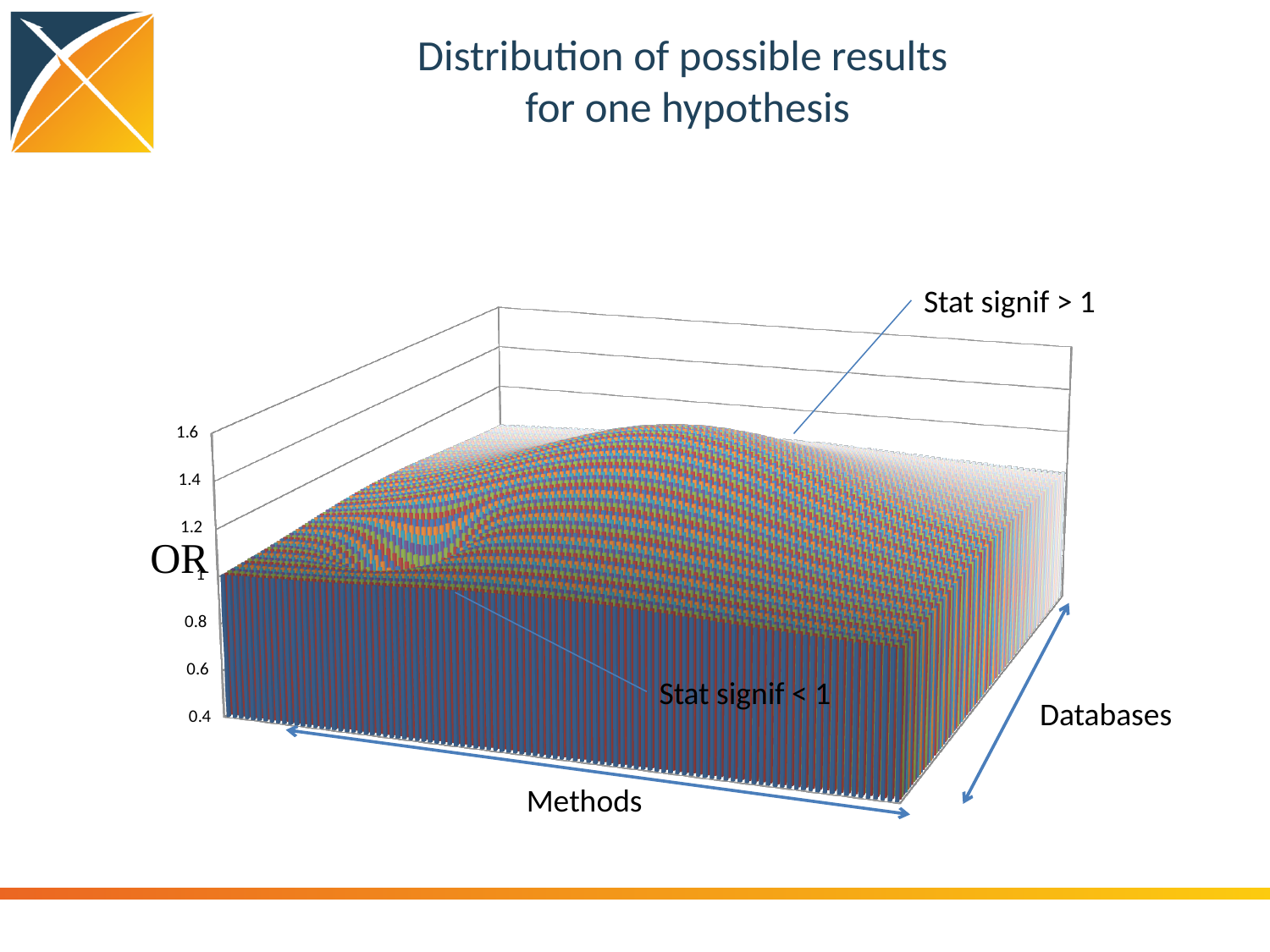
Which two dimensions are labelled along the horizontal axes of the chart? Methods and Databases What is the title of the chart on the slide? Distribution of possible results for one hypothesis Is the highest point of the plotted surface greater or less than 1? greater What label is given to the vertical axis of the chart? OR What is the highest tick value shown on the vertical axis? 1.6 What is the lowest tick value shown on the vertical axis? 0.4